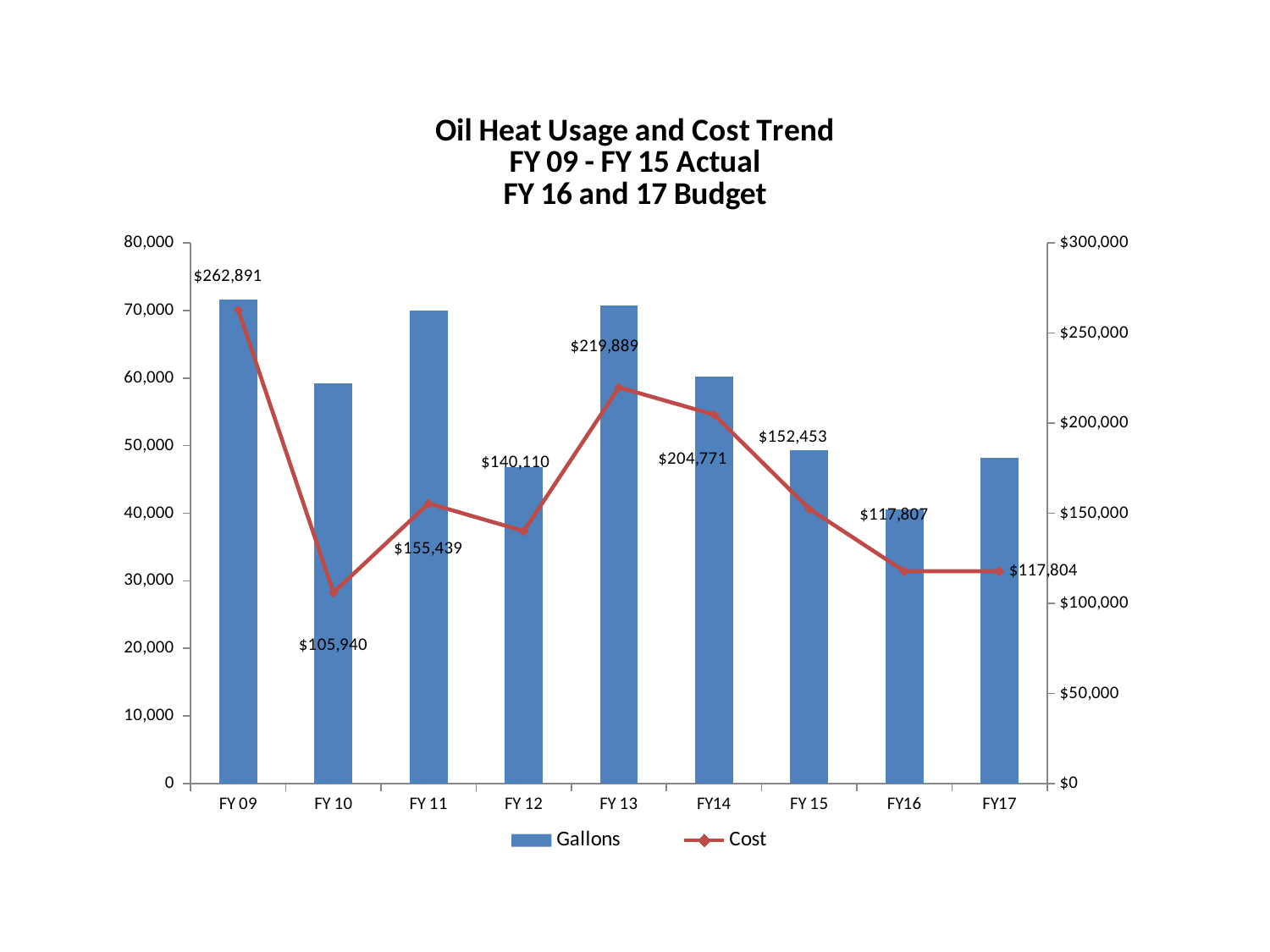
What is the Cost value for FY 13? $219,889 Is the Gallons value for FY16 greater or less than 50,000? less Which has the higher Cost, FY 13 or FY14? FY 13 Does the Cost rise or fall from FY 13 to FY16? fall Which fiscal year has the lowest Cost? FY 10 How many series does the legend list? 2 Is the Gallons value for FY 09 greater or less than 60,000? greater What is the difference in Cost between FY 09 and FY 10? $156,951 Which fiscal year has the highest Cost? FY 09 What is the Cost value for FY 09? $262,891 How many fiscal years are shown on the x axis? 9 What is the Cost value for FY17? $117,804